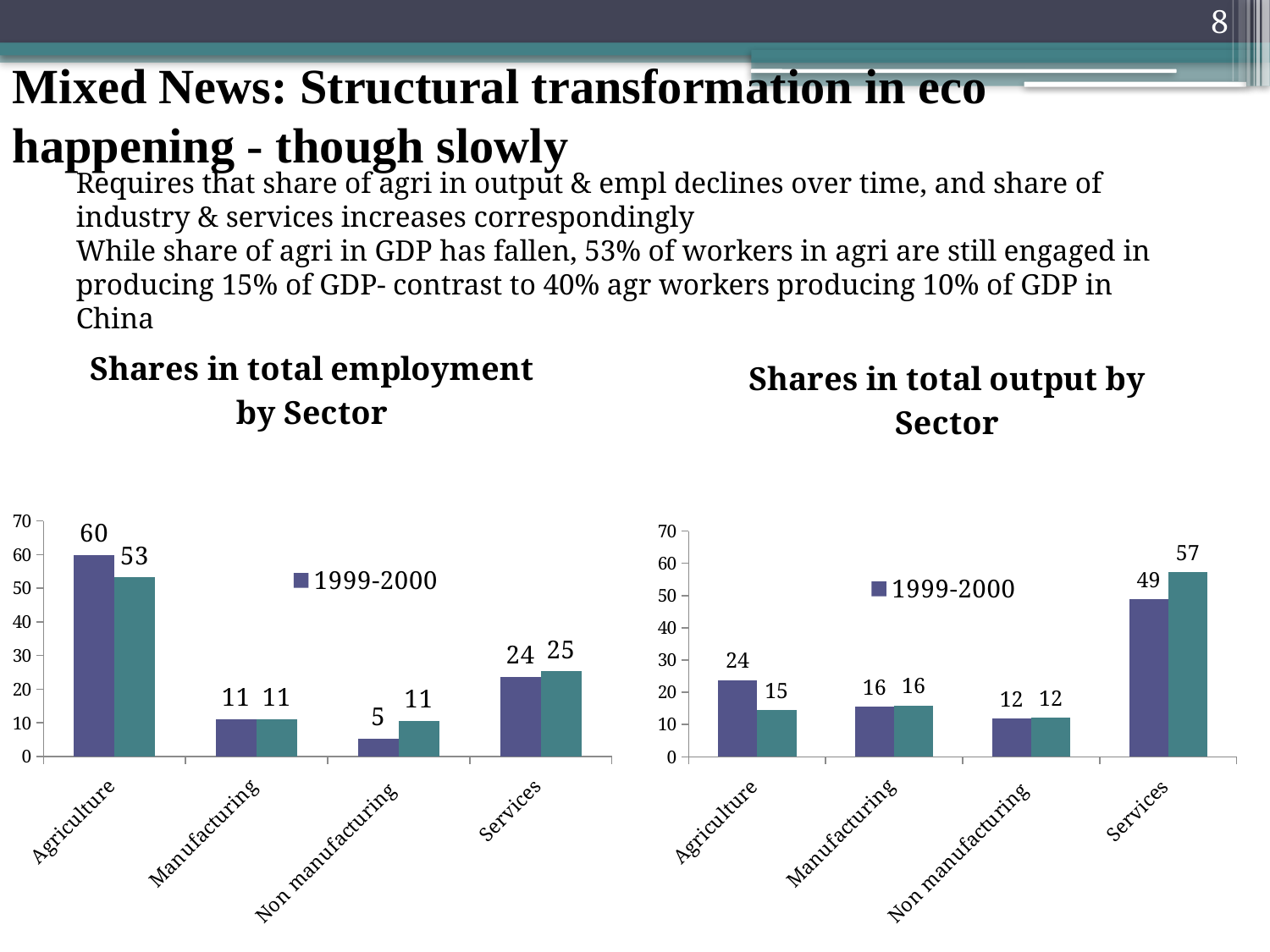
How many categories are shown on the x axis of the 'Shares in total output by Sector' chart? 4 In the 'Shares in total output by Sector' chart, which category has the highest value in the 1999-2000 series? Services How many series does the legend of the 'Shares in total output by Sector' chart list? 1 In the 'Shares in total employment by Sector' chart, what is the value for Agriculture in the 1999-2000 series? 60 In the 'Shares in total employment by Sector' chart, which category has the highest value in the 1999-2000 series? Agriculture What type of chart is the 'Shares in total employment by Sector' chart? Bar chart In the 'Shares in total output by Sector' chart, which is larger in the 1999-2000 series: Manufacturing or Non manufacturing? Manufacturing In the 'Shares in total employment by Sector' chart, what is the value for Services in the 1999-2000 series? 24 In the 'Shares in total output by Sector' chart, what is the value for Agriculture in the 1999-2000 series? 24 In the 'Shares in total employment by Sector' chart, which category has the lowest value in the 1999-2000 series? Non manufacturing In the 'Shares in total output by Sector' chart, what is the value for Services in the 1999-2000 series? 49 In the 'Shares in total employment by Sector' chart, what is the difference between the 1999-2000 values for Agriculture and Services? 36